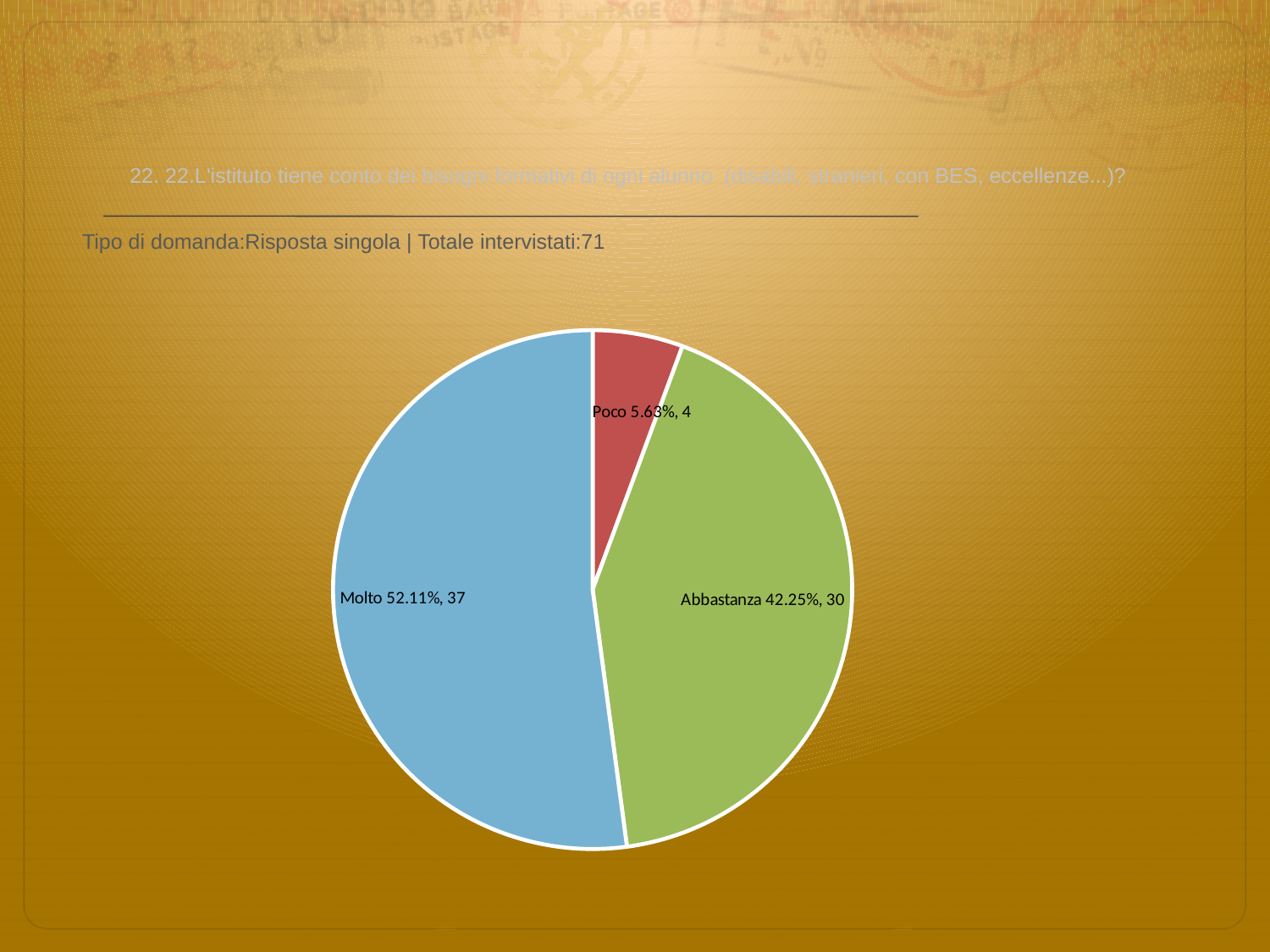
How many respondents answered Abbastanza? 30 What is the difference in respondent count between Molto and Abbastanza? 7 Which slice is larger, Abbastanza or Poco? Abbastanza What percentage share does the Molto slice have? 52.11% What percentage share does the Poco slice have? 5.63% How many respondents answered Poco? 4 What percentage share does the Abbastanza slice have? 42.25% How many slices does the pie chart have? 3 Which category has the smallest slice? Poco What kind of chart is shown on the slide? pie chart Which category has the largest slice? Molto How many respondents answered Molto? 37